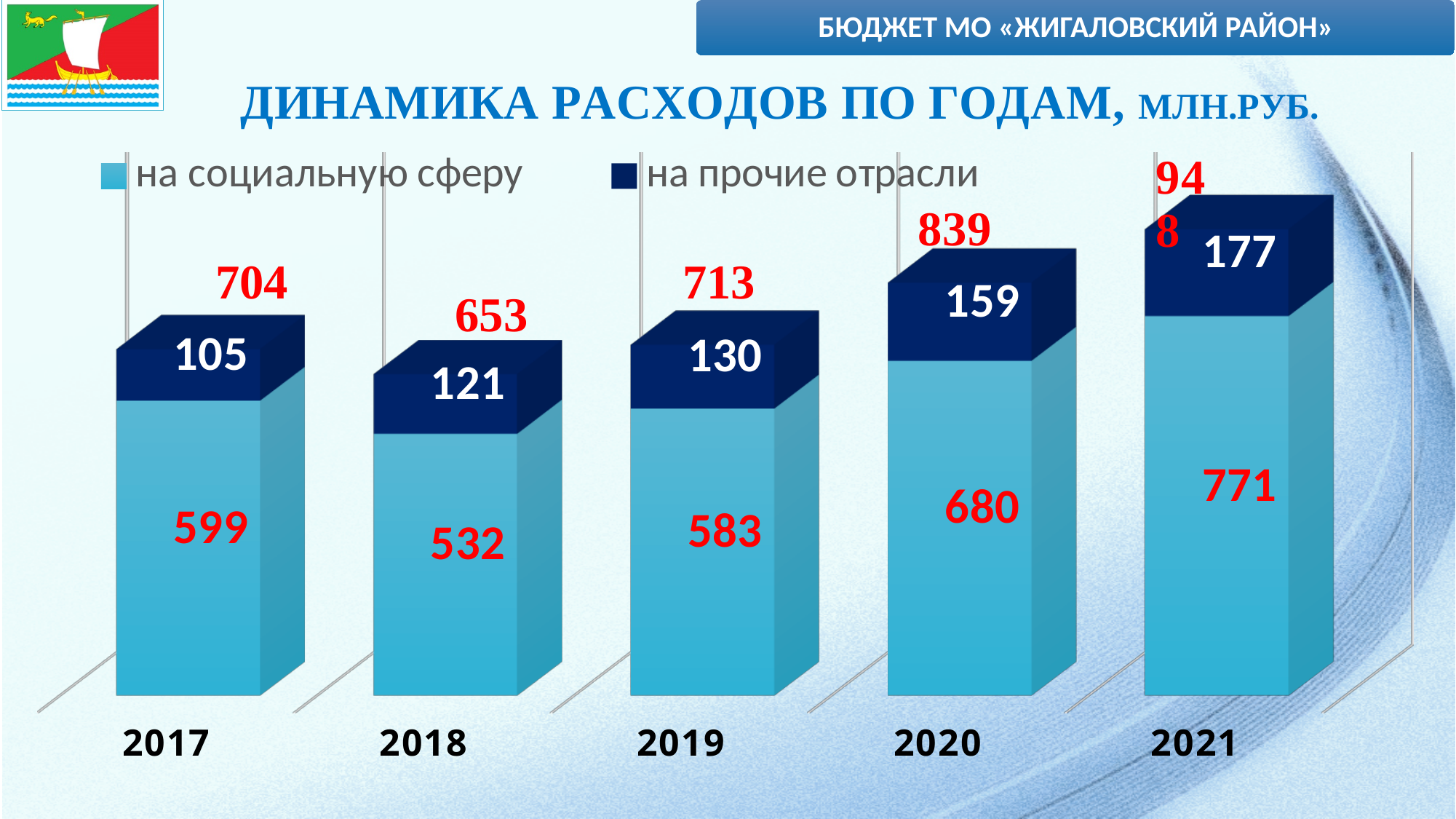
How many years are shown on the x axis? 5 What type of chart is shown on the slide? bar chart What is the total of the stacked bar for 2021? 948 What is the difference between the "на прочие отрасли" values for 2021 and 2017? 72 Which year has the lowest total expenditure? 2018 What is the total expenditure shown for 2020? 839 How many series does the legend list? 2 Which is larger: the "на социальную сферу" value in 2017 or in 2018? 2017 What is the value for "на социальную сферу" in 2019? 583 Which year has the highest value for "на социальную сферу"? 2021 What is the value for "на прочие отрасли" in 2018? 121 Do the total expenditures rise or fall from 2018 to 2021? rise